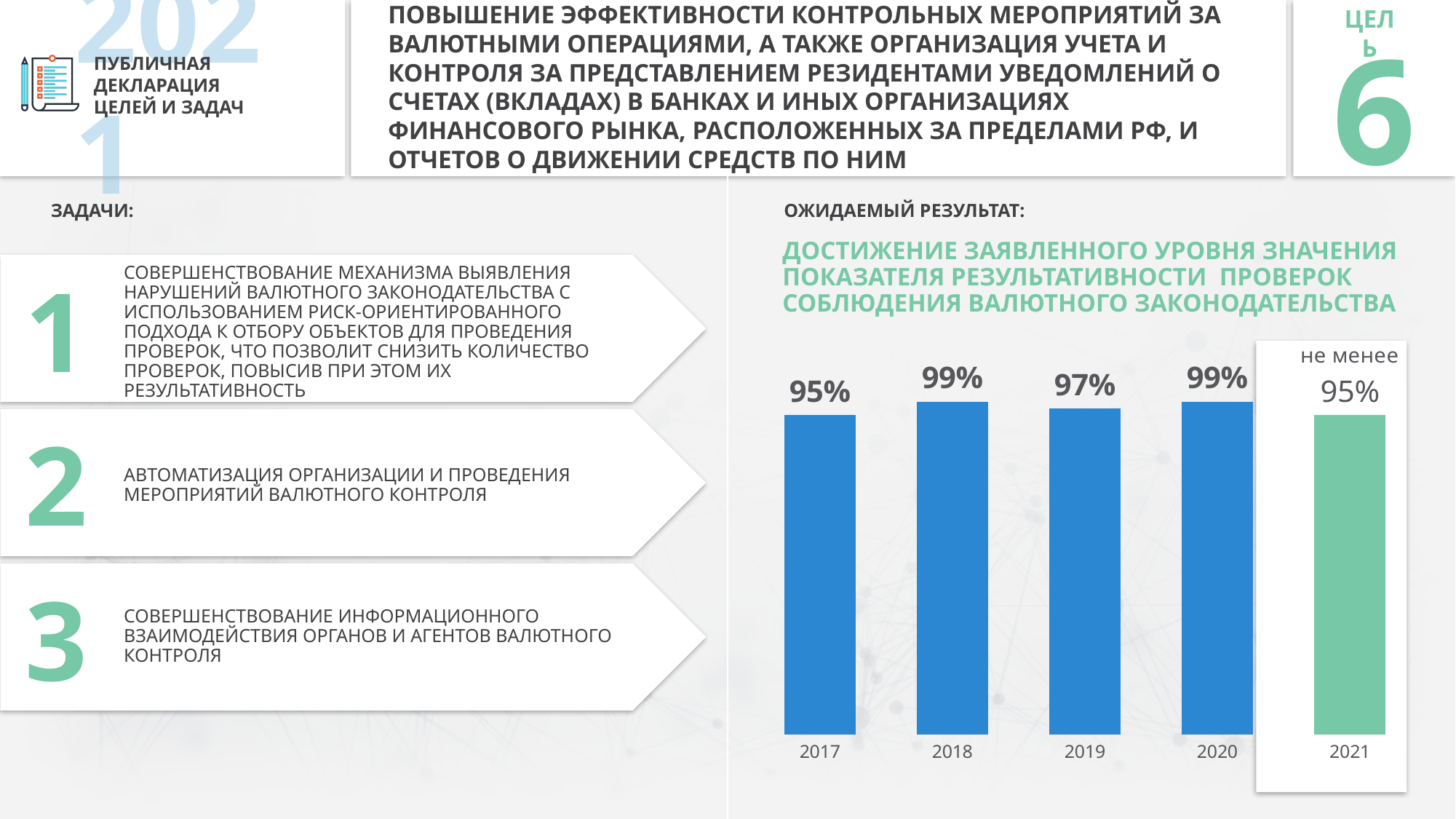
What kind of chart is shown on the slide? Bar chart What is the value shown for 2017 on the chart? 95% What colour is the bar for 2021, compared with the other bars? Green (the others are blue) What is the value shown for 2018 on the chart? 99% What is the difference between the values for 2018 and 2017? 4 percentage points What target value is shown for 2021 on the chart? не менее 95% What is the difference between the values for 2020 and 2019? 2 percentage points Which is larger, the value for 2017 or the value for 2020? 2020 What is the value shown for 2019 on the chart? 97% What is the value shown for 2020 on the chart? 99% How many years are shown on the chart? 5 Which is larger, the value for 2018 or the value for 2019? 2018